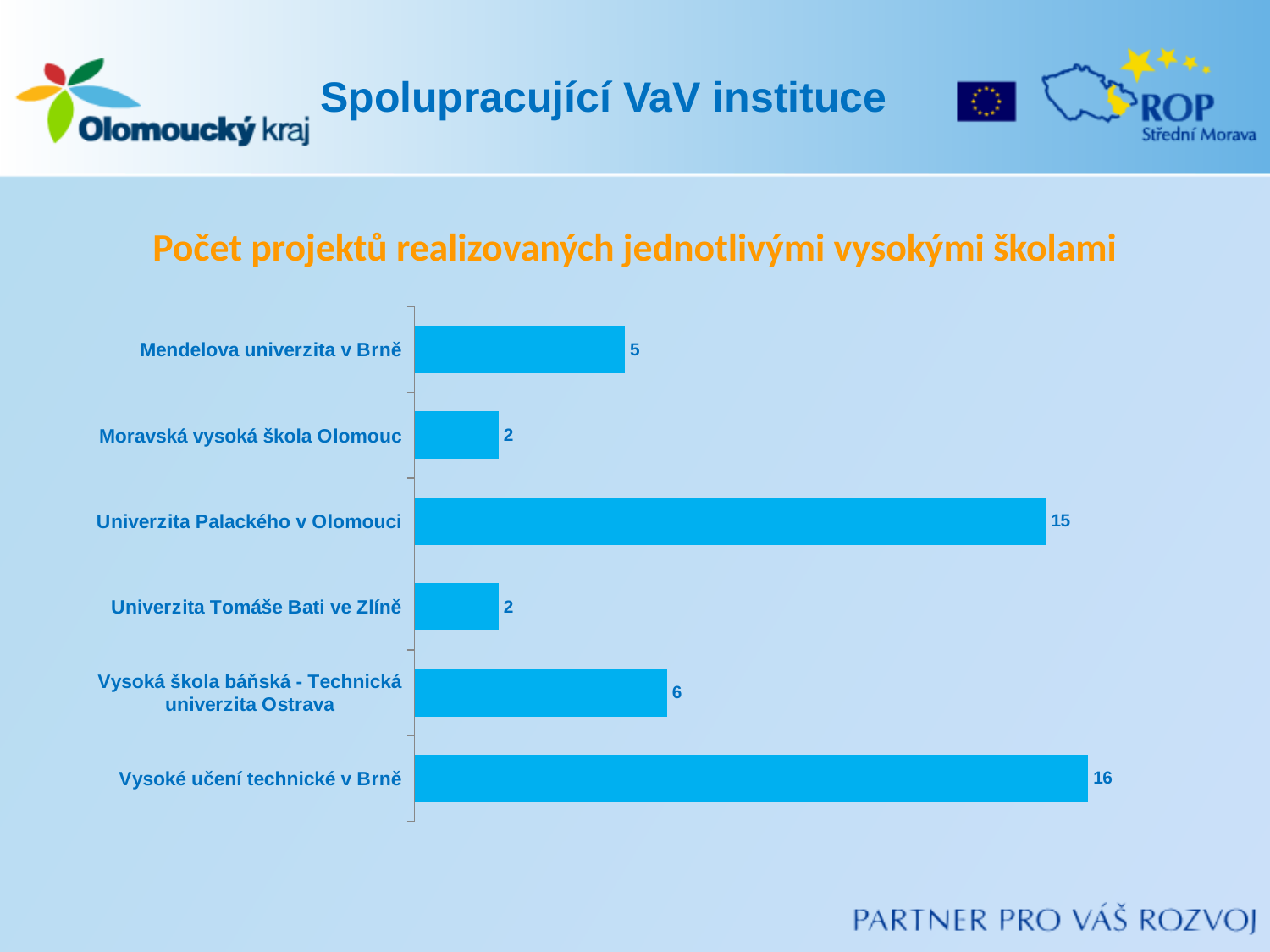
What is the value shown for Univerzita Tomáše Bati ve Zlíně? 2 What is the value shown for Mendelova univerzita v Brně? 5 How many universities have a value of 2? 2 What is the value shown for Vysoká škola báňská - Technická univerzita Ostrava? 6 How many projects were realized by Univerzita Palackého v Olomouci? 15 Which university has the highest number of projects? Vysoké učení technické v Brně How many universities are shown in the chart? 6 What is the difference between the values for Vysoké učení technické v Brně and Univerzita Palackého v Olomouci? 1 What is the title of the chart? Počet projektů realizovaných jednotlivými vysokými školami Which is larger, the value for Mendelova univerzita v Brně or the value for Vysoká škola báňská - Technická univerzita Ostrava? Vysoká škola báňská - Technická univerzita Ostrava What is the difference between the values for Univerzita Palackého v Olomouci and Moravská vysoká škola Olomouc? 13 What kind of chart is shown on the slide? bar chart